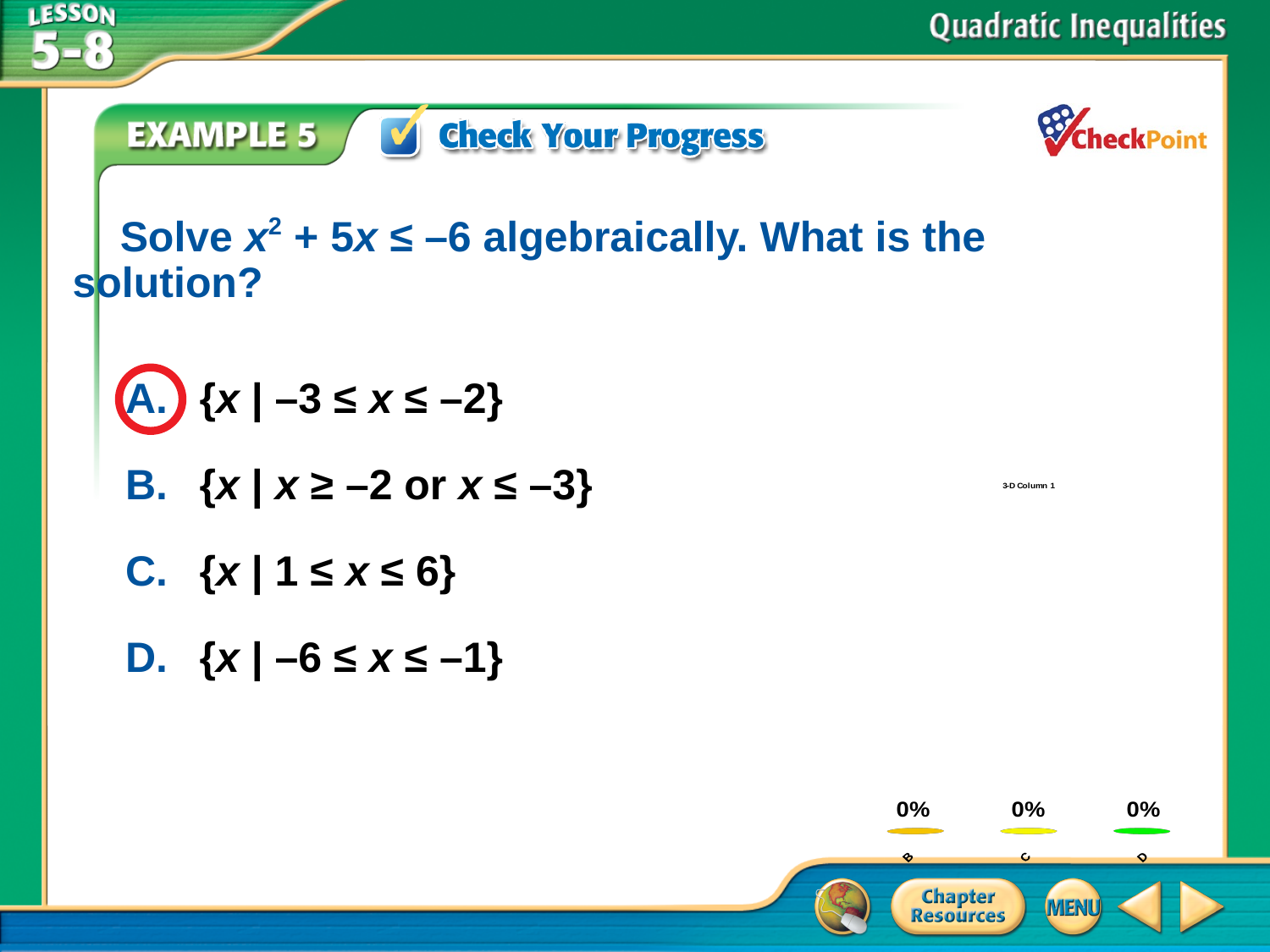
In the response chart at the bottom right of the slide, what is the difference between the values for B and D? 0% What kind of chart is the response chart at the bottom right of the slide? bar chart What value is shown for category B in the response chart at the bottom right of the slide? 0% What value is shown for category D in the response chart at the bottom right of the slide? 0% What value is shown for category C in the response chart at the bottom right of the slide? 0%